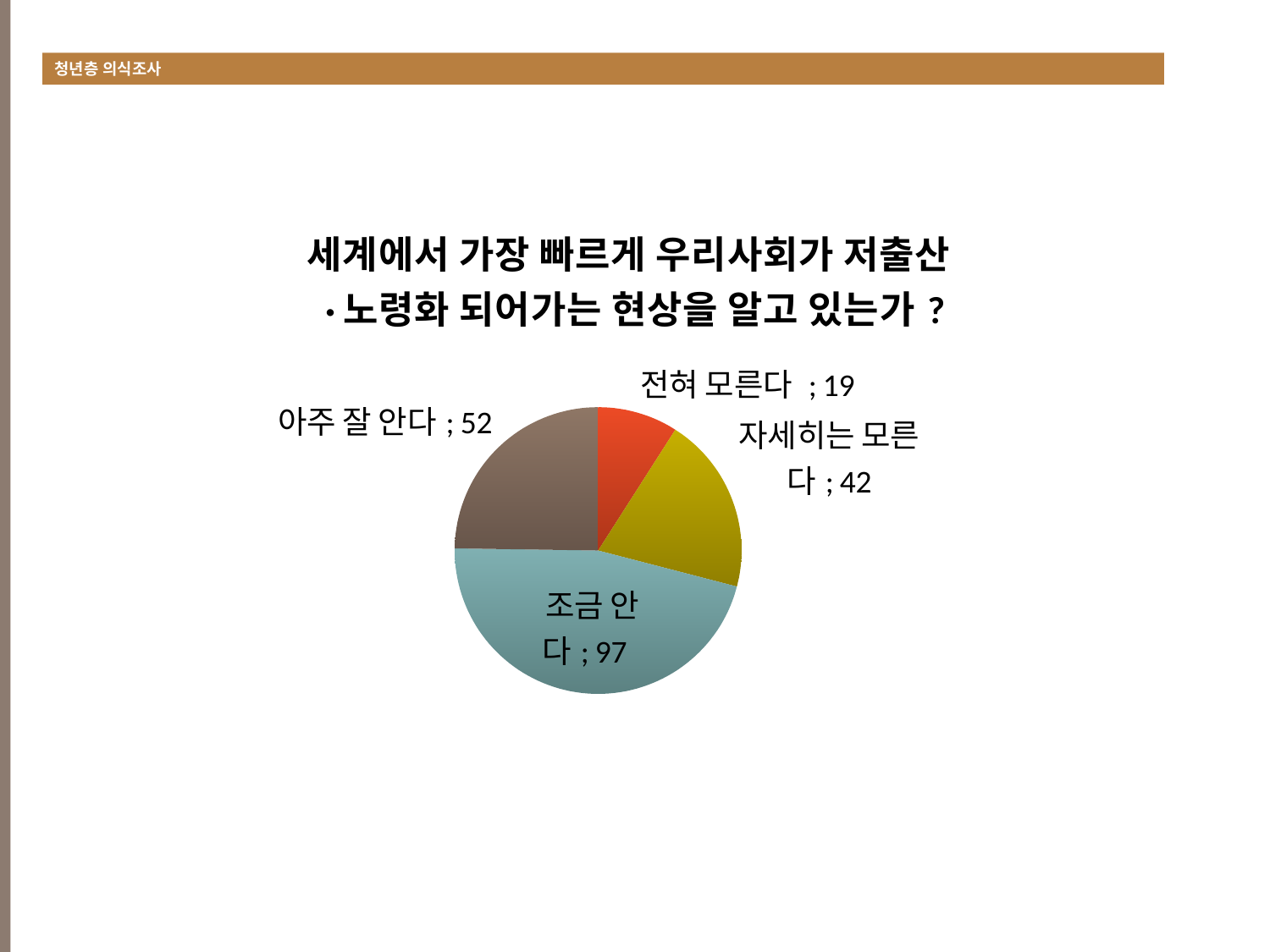
What is the value for 자세히는 모른다 in the pie chart? 42 What is the value for 전혀 모른다 in the pie chart? 19 What is the difference between the values for 조금 안다 and 아주 잘 안다? 45 Which category has the smallest slice in the pie chart? 전혀 모른다 How many categories are shown in the pie chart? 4 What is the total of all the values in the pie chart? 210 What is the value for 아주 잘 안다 in the pie chart? 52 What is the value for 조금 안다 in the pie chart? 97 Which is larger, the value for 아주 잘 안다 or the value for 자세히는 모른다? 아주 잘 안다 What kind of chart is shown on the slide? pie chart Which category has the largest slice in the pie chart? 조금 안다 What share of the pie does 자세히는 모른다 represent? 20%